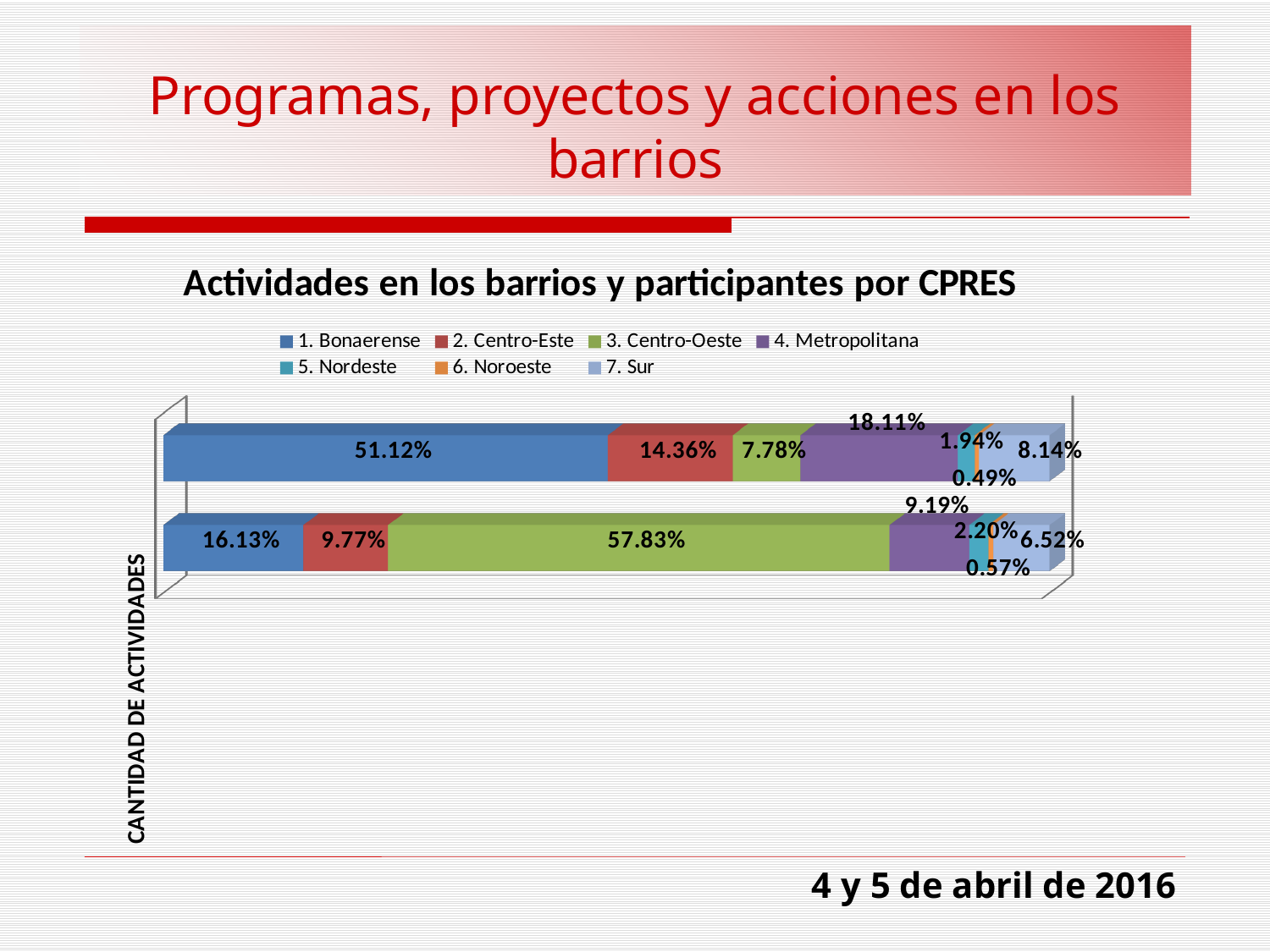
What is the value for 6. Noroeste in the bottom bar? 0.57% What is the title of the chart? Actividades en los barrios y participantes por CPRES What is the value for 1. Bonaerense in the top bar? 51.12% How many bars are plotted in the chart? 2 What is the value for 3. Centro-Oeste in the bottom bar? 57.83% What is the value for 4. Metropolitana in the top bar? 18.11% In the bottom bar, which is larger: the value for 2. Centro-Este or the value for 7. Sur? 2. Centro-Este In the top bar, how much larger is the value for 1. Bonaerense than the value for 2. Centro-Este? 36.76 percentage points How many series does the legend list? 7 Which series has the largest segment in the bottom bar? 3. Centro-Oeste Which series has the smallest segment in the top bar? 6. Noroeste What kind of chart is shown on the slide? Stacked bar chart